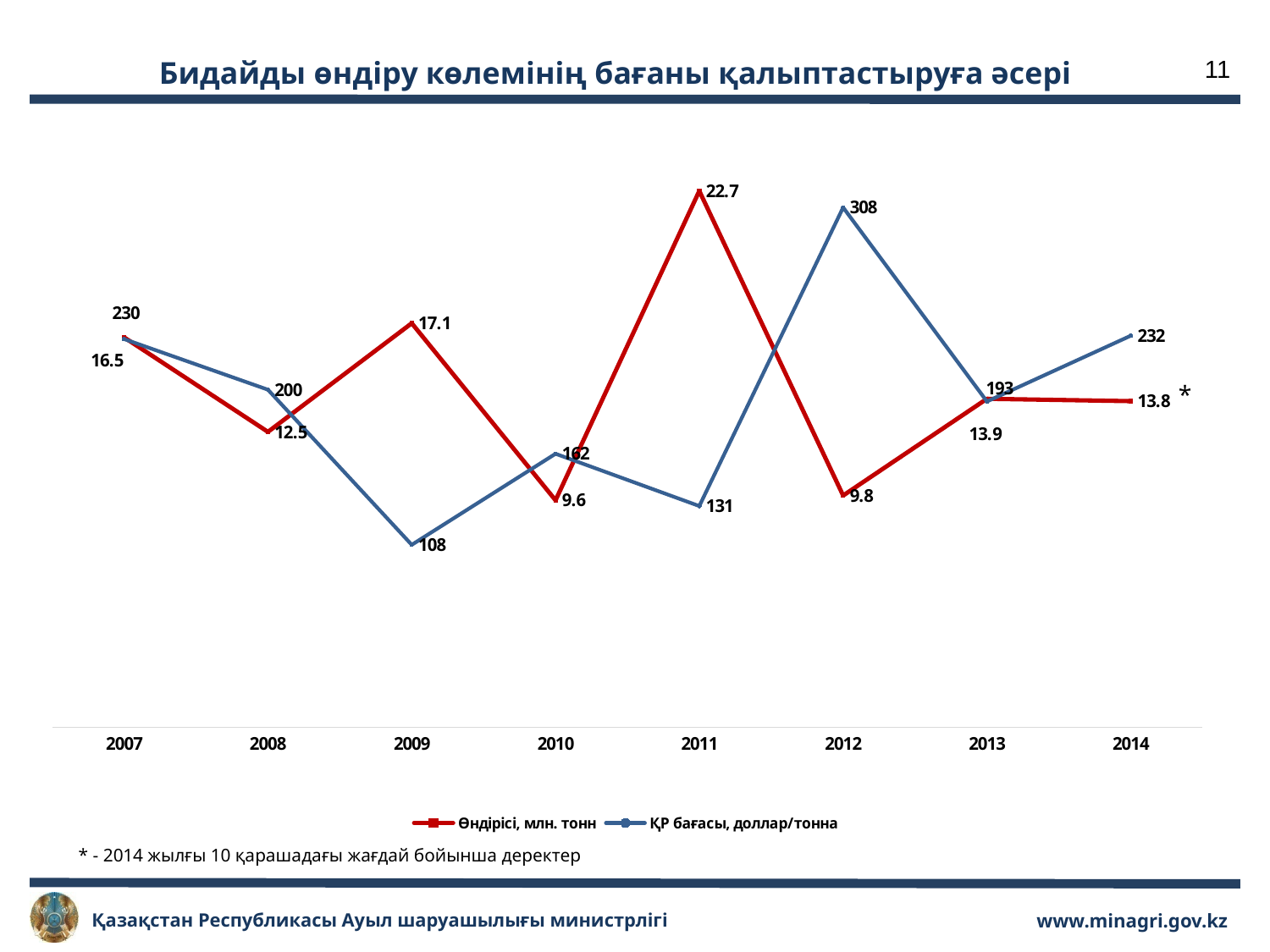
What type of chart is shown on the slide? line chart What is the difference between the "ҚР бағасы, доллар/тонна" values for 2012 and 2011? 177 How many series does the legend list? 2 Which colour is used for the "ҚР бағасы, доллар/тонна" series? blue In which year is "ҚР бағасы, доллар/тонна" lowest? 2009 What is the value of "Өндірісі, млн. тонн" in 2014? 13.8 What is the value of "Өндірісі, млн. тонн" in 2011? 22.7 What is the value of "ҚР бағасы, доллар/тонна" in 2009? 108 What is the value of "ҚР бағасы, доллар/тонна" in 2012? 308 Which is larger for "Өндірісі, млн. тонн": the 2009 value or the 2010 value? 2009 In which year is "Өндірісі, млн. тонн" highest? 2011 How many years are shown on the x axis? 8